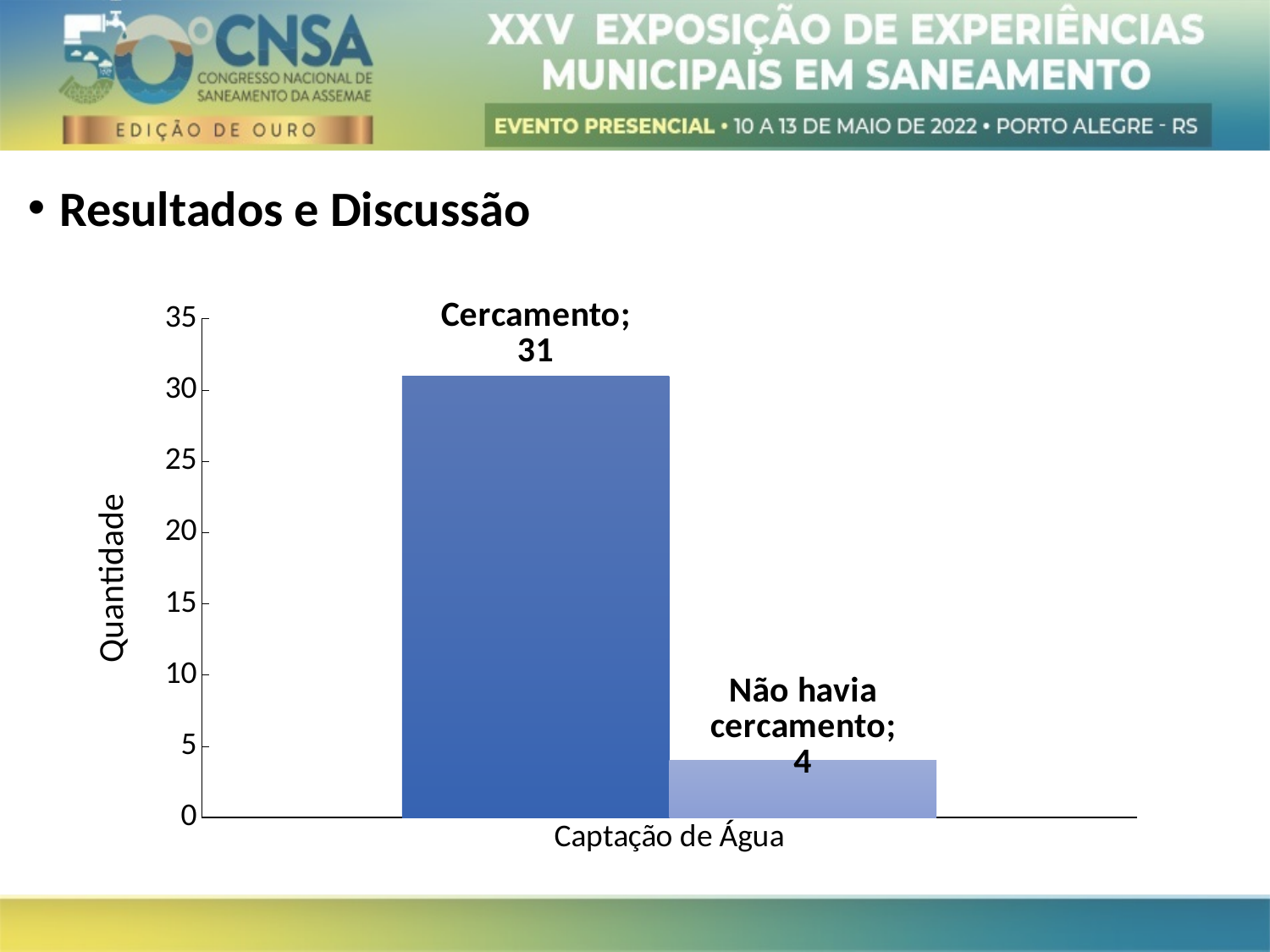
Which bar has the lowest value? Não havia cercamento Which is larger, the value for Cercamento or the value for Não havia cercamento? Cercamento What is the label of the vertical axis? Quantidade What is the value for Cercamento? 31 Is the value for Cercamento greater or less than 30? greater What kind of chart is shown on the slide? bar chart Is the value for Não havia cercamento greater or less than 5? less What is the difference between the values for Cercamento and Não havia cercamento? 27 What is the total of the two bar values? 35 What is the value for Não havia cercamento? 4 How many bars are plotted in the chart? 2 Which bar has the highest value? Cercamento